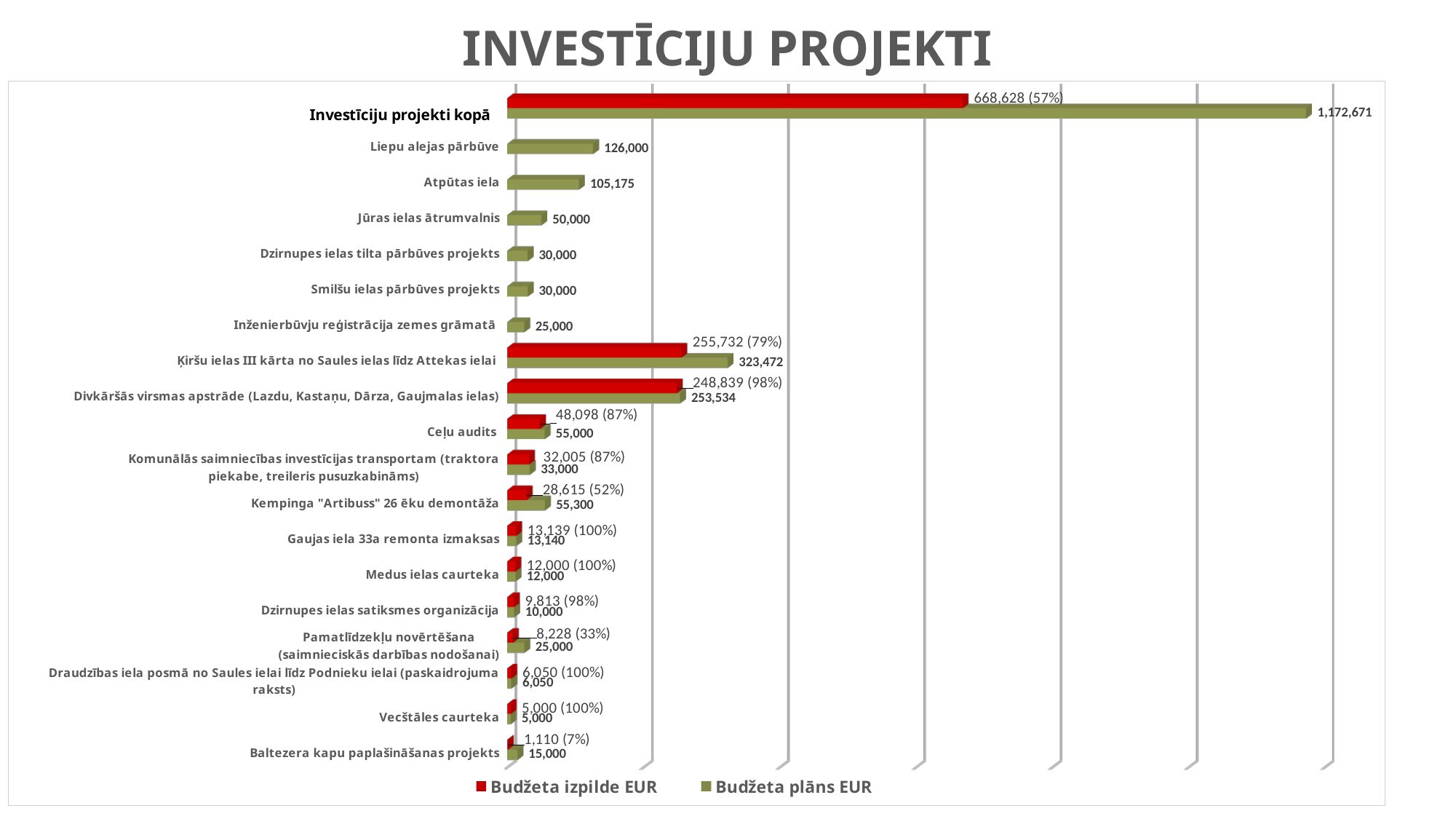
How many series does the legend list? 2 What is the difference between the Budžeta plāns EUR and Budžeta izpilde EUR values for Kempinga "Artibuss" 26 ēku demontāža? 26,685 What is the difference between the Budžeta plāns EUR and Budžeta izpilde EUR values for Ceļu audits? 6,902 What is the Budžeta izpilde EUR label shown for Ķiršu ielas III kārta no Saules ielas līdz Attekas ielai? 255,732 (79%) What type of chart is shown on the slide? Bar chart How many categories (rows) are shown on the chart, including the total row? 19 Which project has the lowest Budžeta plāns EUR value? Vecštāles caurteka Excluding the total row (Investīciju projekti kopā), which project has the highest Budžeta plāns EUR value? Ķiršu ielas III kārta no Saules ielas līdz Attekas ielai What is the Budžeta plāns EUR value for Kempinga "Artibuss" 26 ēku demontāža? 55,300 Which has the larger Budžeta plāns EUR value, Atpūtas iela or Liepu alejas pārbūve? Liepu alejas pārbūve What is the Budžeta plāns EUR value for Liepu alejas pārbūve? 126,000 What is the Budžeta izpilde EUR label shown for Investīciju projekti kopā? 668,628 (57%)